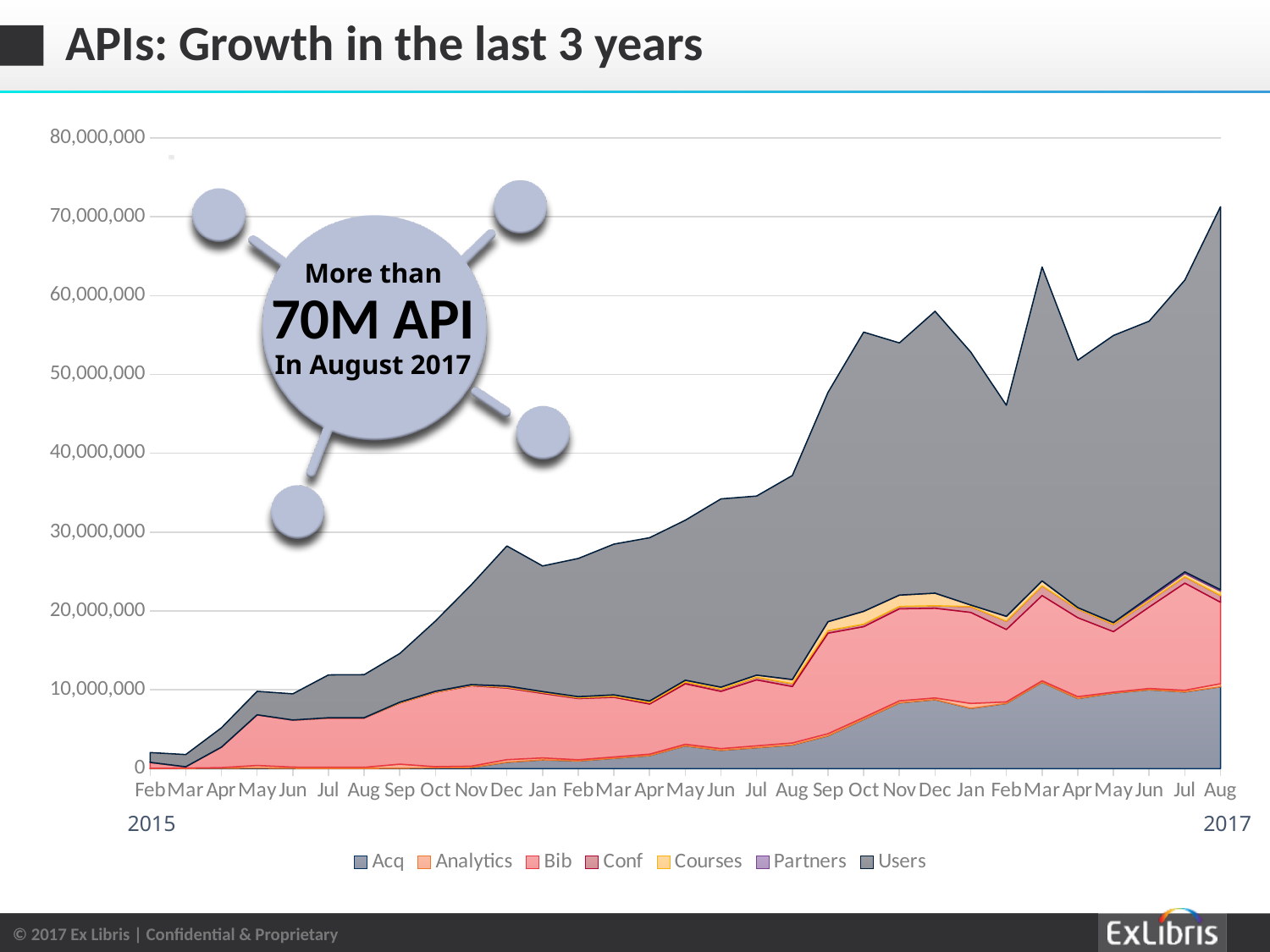
Is the total value for Feb 2015 greater or less than 10,000,000? less What is the title of the chart on the slide? APIs: Growth in the last 3 years Do the total API values generally rise or fall from Feb 2015 to Aug 2017? Rise Which has the larger total value, Feb 2015 or Aug 2017? Aug 2017 What kind of chart is shown on the slide? Stacked area chart In which month is the total API value highest? Aug 2017 Is the total value for Feb 2017 greater or less than 50,000,000? less How many series does the legend list? 7 Is the total value for Mar 2017 greater or less than 60,000,000? greater Which series is listed last in the legend? Users How many months are plotted along the x axis? 31